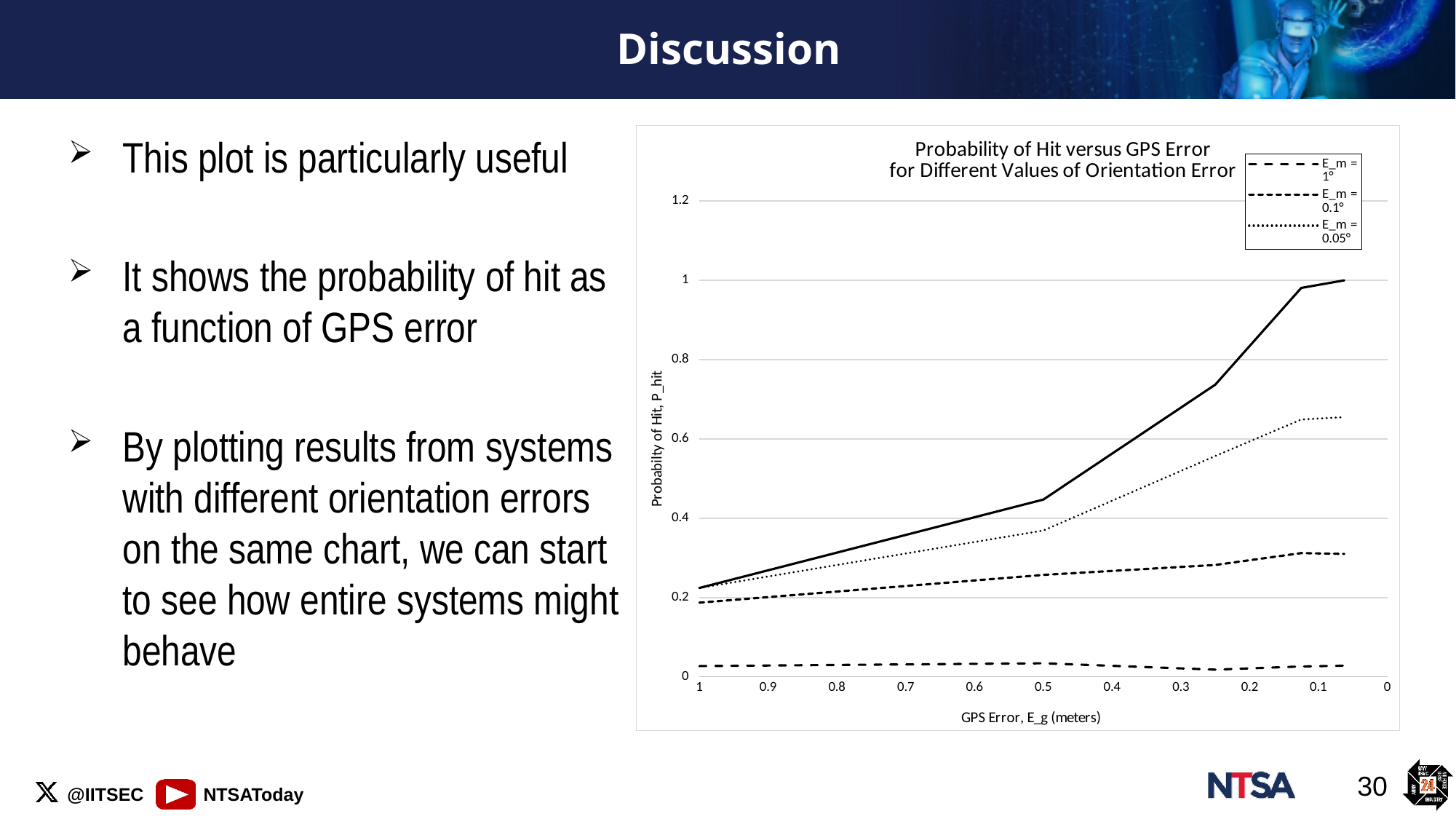
Moving from left to right along the x axis (from GPS error 1 toward 0), does the probability of hit for the E_m = 0.05° series rise or fall? rise What is the label of the chart's x axis? GPS Error, E_g (meters) How many series does the chart's legend list? 3 What is the title of the chart? Probability of Hit versus GPS Error for Different Values of Orientation Error Is the value of the solid line at a GPS error of 0.1 greater or less than 0.8? greater Which series in the legend has the lowest probability of hit across the chart? E_m = 1° Is the value of the E_m = 0.05° series at a GPS error of 0.1 greater or less than 0.4? greater What kind of chart is shown on the slide? line chart What is the highest tick value shown on the y axis? 1.2 At a GPS error of 0.5, which series has the higher probability of hit, E_m = 0.05° or E_m = 0.1°? E_m = 0.05° Is the value of the E_m = 0.1° series at a GPS error of 0.1 greater or less than 0.2? greater